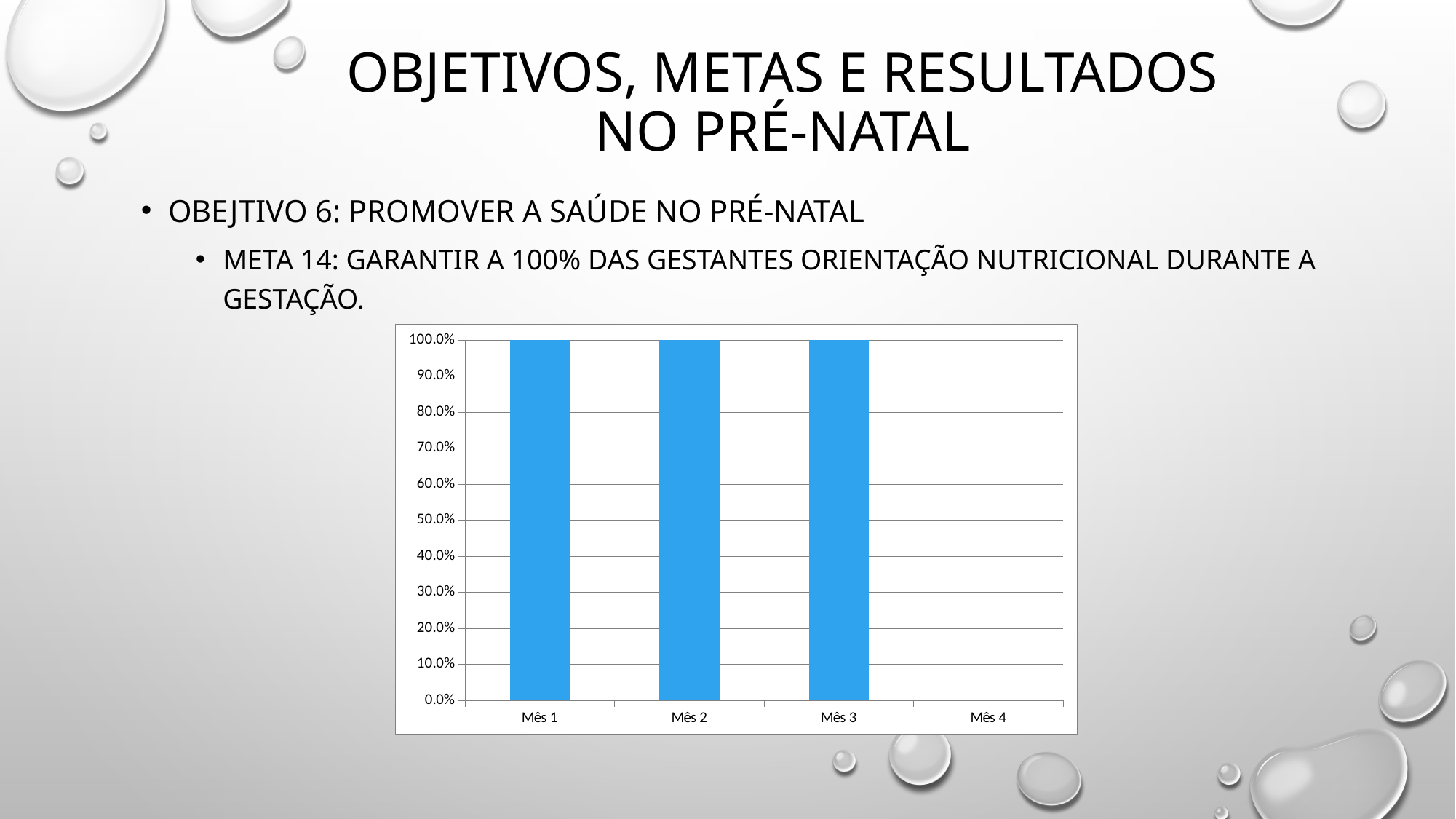
Is the value for Mês 4 greater or less than 10.0%? less What is the value for Mês 3? 100.0% Which is larger, the value for Mês 3 or the value for Mês 4? Mês 3 What kind of chart is shown on the slide? bar chart What is the highest value shown on the y axis of the chart? 100.0% How many categories are shown on the x axis of the chart? 4 What colour are the bars in the chart? blue What is the value for Mês 2? 100.0% Which category has the lowest value in the chart? Mês 4 What is the value for Mês 1? 100.0% Is the value for Mês 2 greater or less than 50.0%? greater What is the difference between the values for Mês 1 and Mês 2? 0.0%